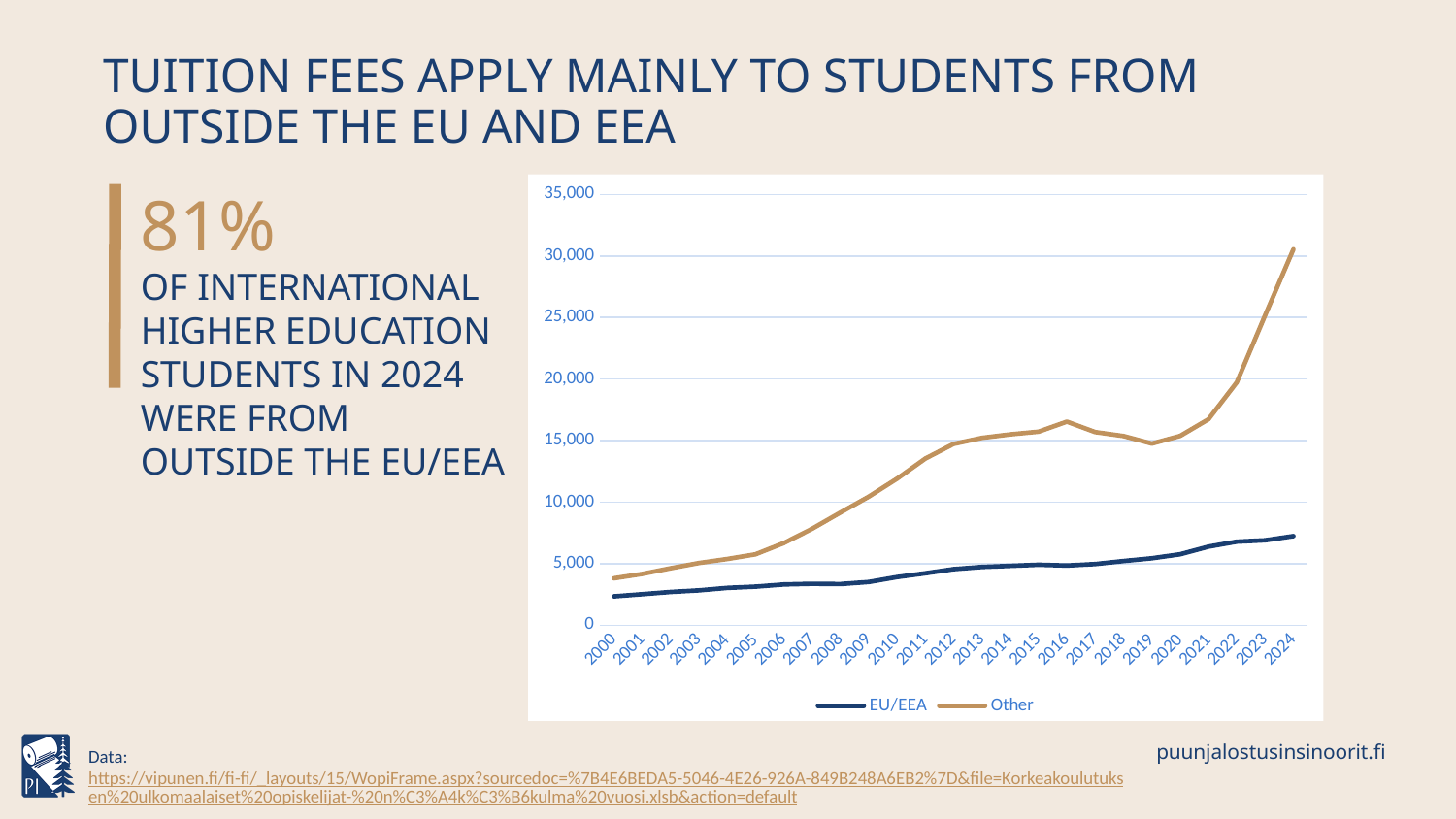
Is the value for Other in 2008 greater or less than 10,000? less Is the value for Other in 2024 greater or less than 25,000? greater How many years are shown along the x axis of the chart? 25 Does the Other series rise or fall overall from 2000 to 2024? rise Which year is the first on the x axis of the chart? 2000 In which year is the Other series at its lowest value? 2000 In 2024, which series has the larger value, EU/EEA or Other? Other How many series does the chart legend list? 2 What kind of chart is shown on the slide? line chart Is the value for EU/EEA in 2024 greater or less than 10,000? less In which year does the Other series reach its highest value? 2024 What are the two series named in the chart legend? EU/EEA and Other